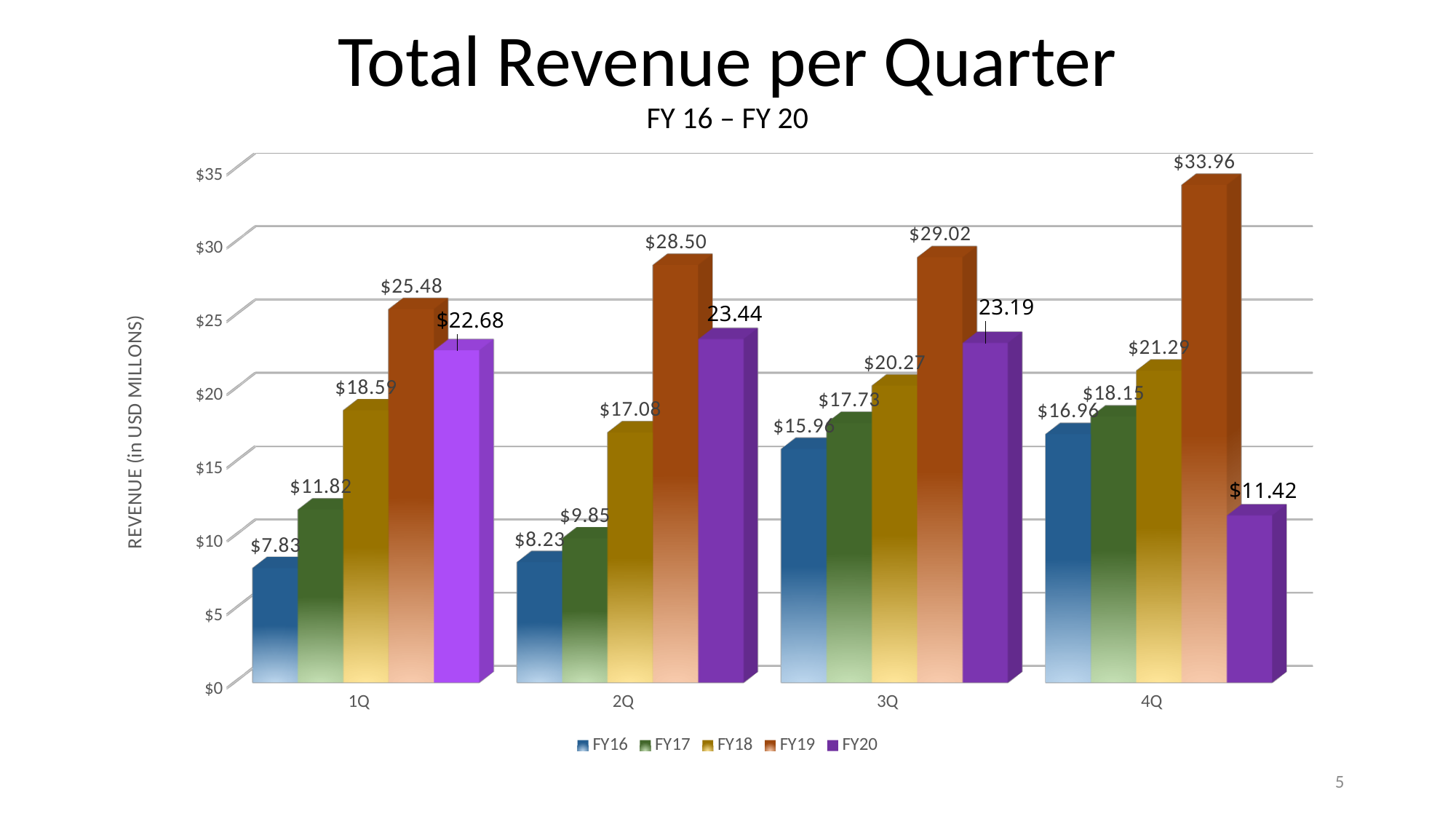
Do the FY17 revenue values rise or fall from 1Q to 4Q? Rise How many quarters are shown on the x axis? 4 Which quarter has the highest FY19 revenue? 4Q Which quarter has the lowest FY20 revenue? 4Q What is the FY18 revenue for 3Q? $20.27 What is the difference between the FY19 and FY18 revenue in 4Q? $12.67 Which is larger in 1Q: the FY19 revenue or the FY20 revenue? FY19 What is the FY20 revenue for 2Q? 23.44 What kind of chart is shown on the slide? Bar chart What is the FY19 revenue for 4Q? $33.96 What is the FY16 revenue for 1Q? $7.83 How many series does the legend list? 5